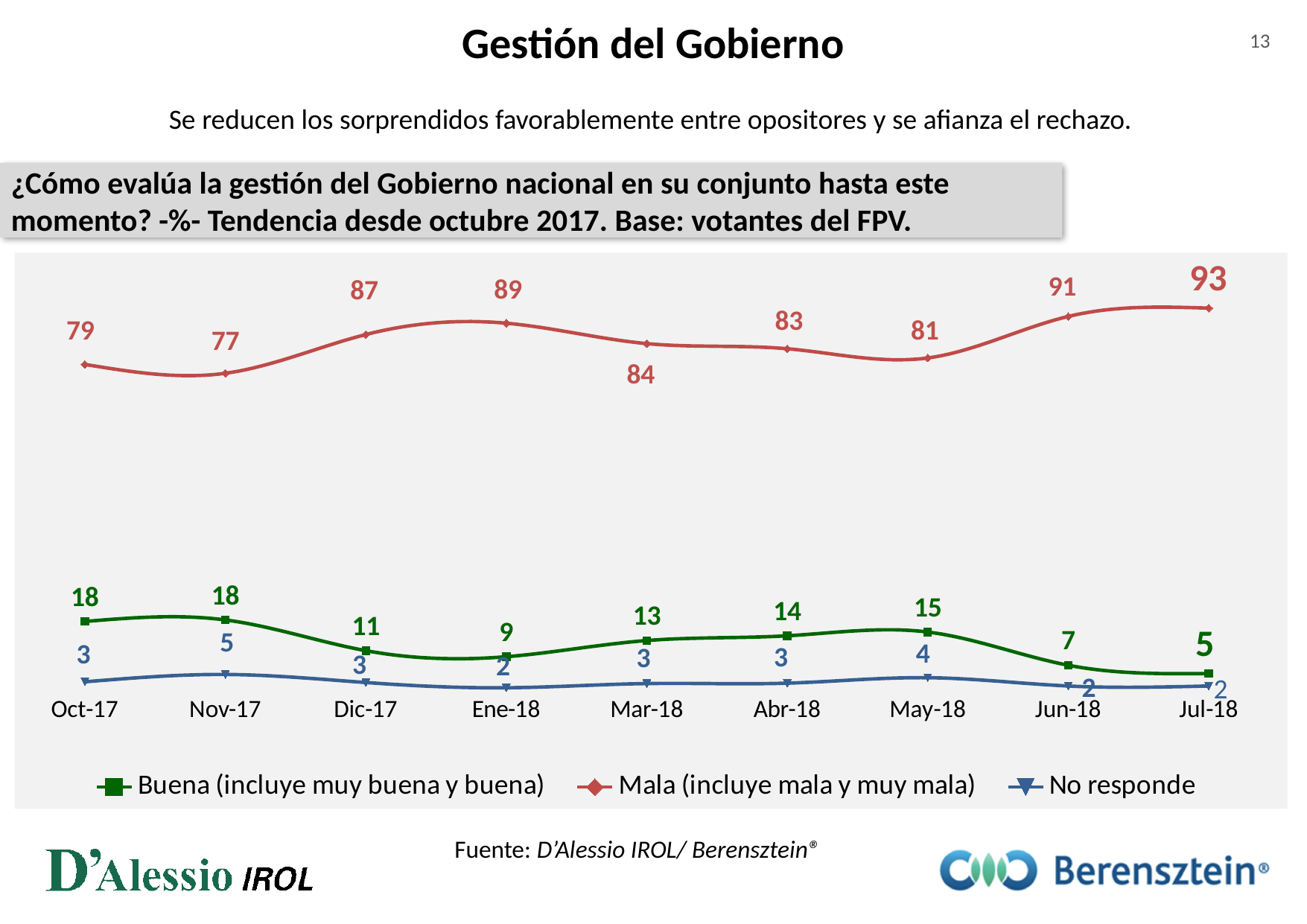
How many series does the legend list? 3 In which month does the Mala series reach its highest value? Jul-18 Which is larger: the Buena value in May-18 or the Buena value in Jun-18? May-18 What kind of chart is shown on the slide? Line chart How many time points are plotted on the x axis? 9 In which month is the Buena series at its lowest value? Jul-18 What is the difference between the Mala value in Jul-18 and the Mala value in Oct-17? 14 What is the value for Mala (incluye mala y muy mala) in Jul-18? 93 What colour is the line for the Mala (incluye mala y muy mala) series? Red What is the value for Buena (incluye muy buena y buena) in Oct-17? 18 What is the value for No responde in Nov-17? 5 Does the Buena series rise or fall from May-18 to Jul-18? Fall